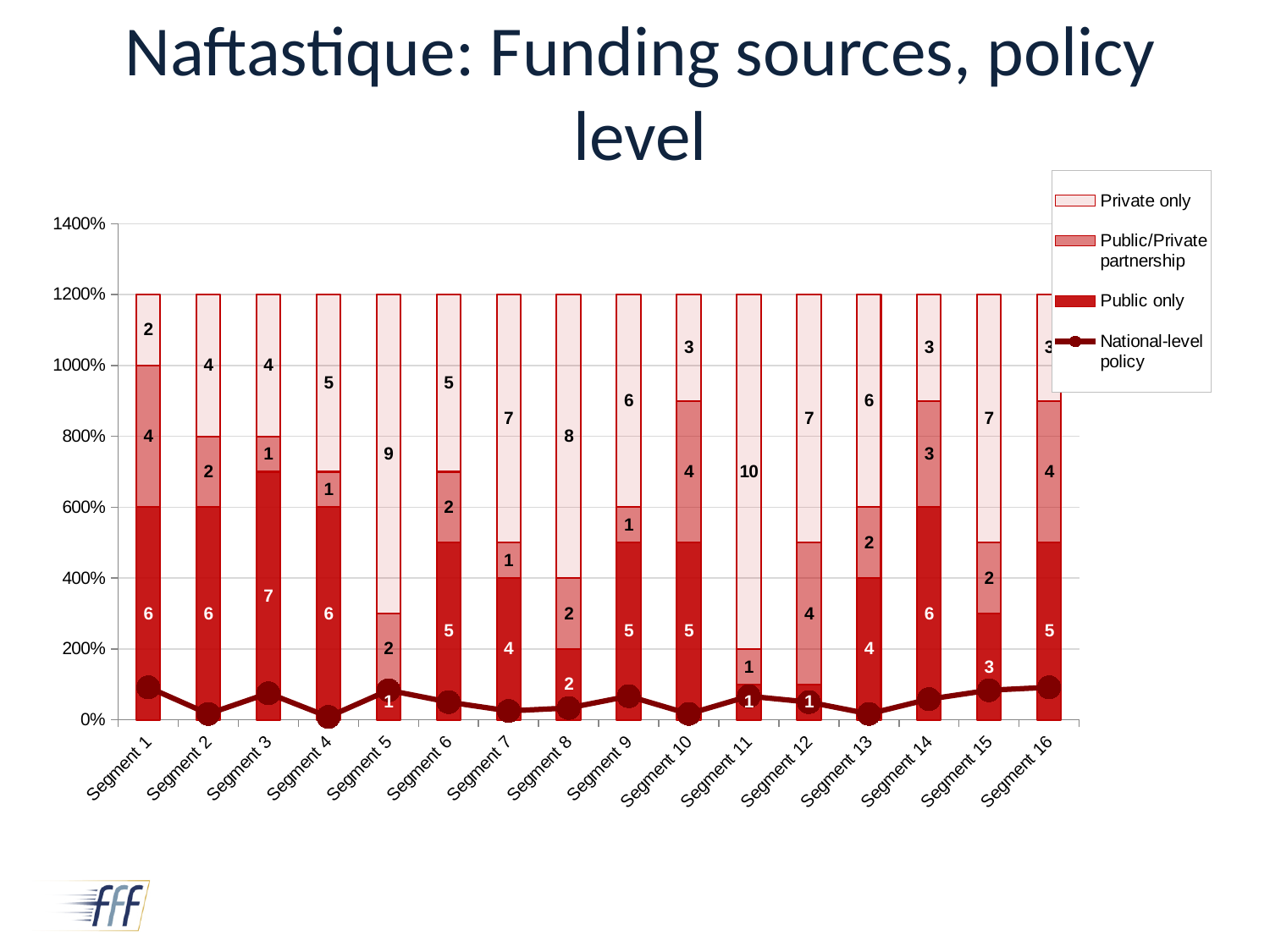
How many segments are shown on the x axis? 16 What is the Public only value for Segment 3? 7 What kind of chart is used for the funding sources? Stacked bar chart What is the Private only value for Segment 11? 10 What is the total of the three stacked values for Segment 8? 12 Which segment has the highest Private only value? Segment 11 What is the difference between the Private only values for Segment 5 and Segment 1? 7 Which is larger, the Public only value for Segment 14 or for Segment 15? Segment 14 Which segment has the lowest Private only value? Segment 1 What is the Public/Private partnership value for Segment 12? 4 Which series is drawn as a line with markers rather than as bars? National-level policy How many series does the legend list? 4